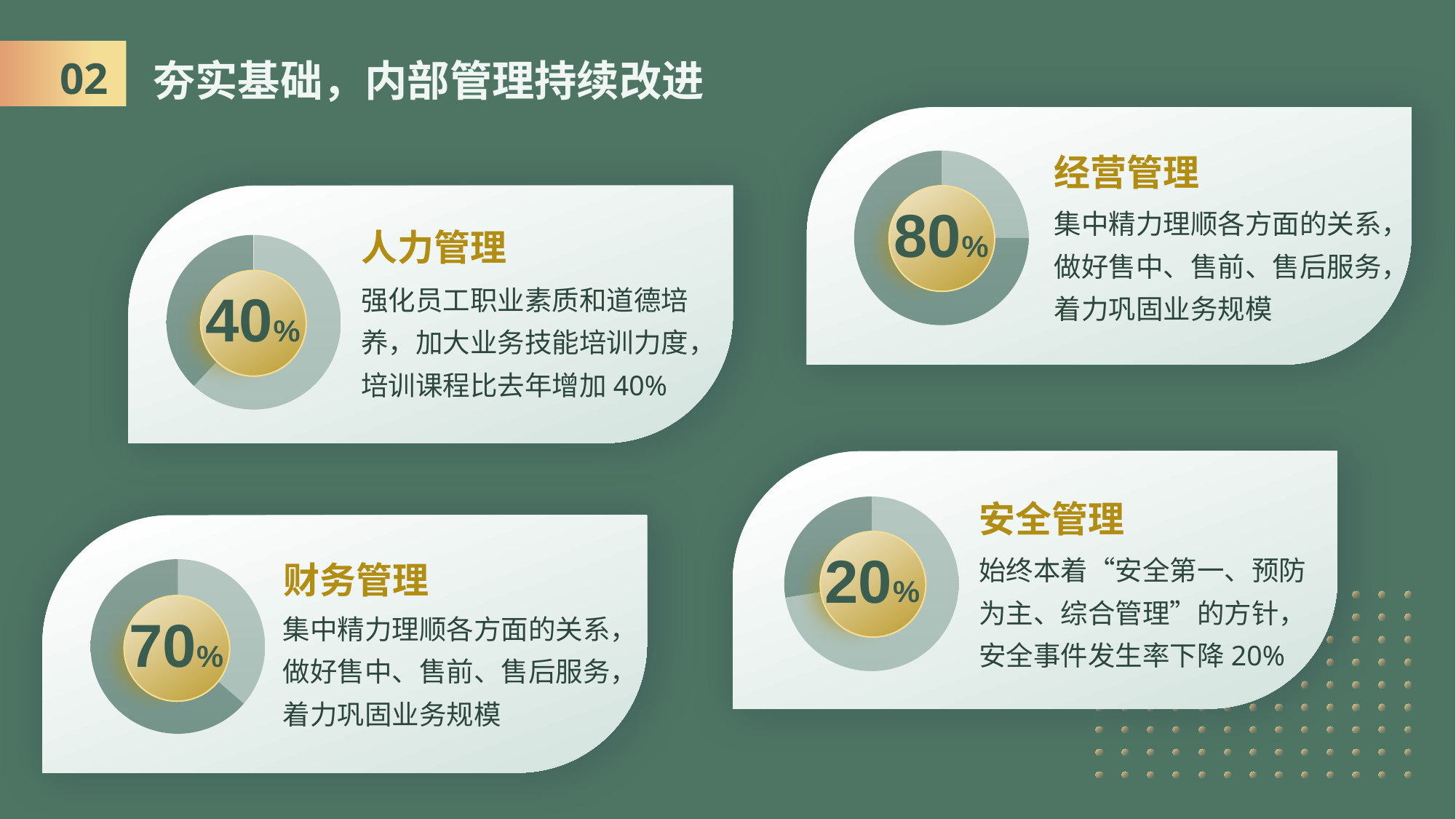
How many donut charts are on the slide? 4 What is the title of the slide containing the four donut charts? 夯实基础，内部管理持续改进 Which shows a larger percentage, the 财务管理 chart or the 人力管理 chart? 财务管理 What is the difference between the percentage in the 经营管理 chart and the percentage in the 安全管理 chart? 60% Which of the four donut charts shows the lowest percentage? 安全管理 What percentage is shown in the 安全管理 donut chart? 20% What percentage is shown in the 经营管理 donut chart? 80% What kind of chart is used to display the percentage for 人力管理? Donut chart Which of the four donut charts shows the highest percentage? 经营管理 What percentage is shown in the 财务管理 donut chart? 70% What is the difference between the percentage in the 财务管理 chart and the percentage in the 人力管理 chart? 30% What percentage is shown in the 人力管理 donut chart? 40%